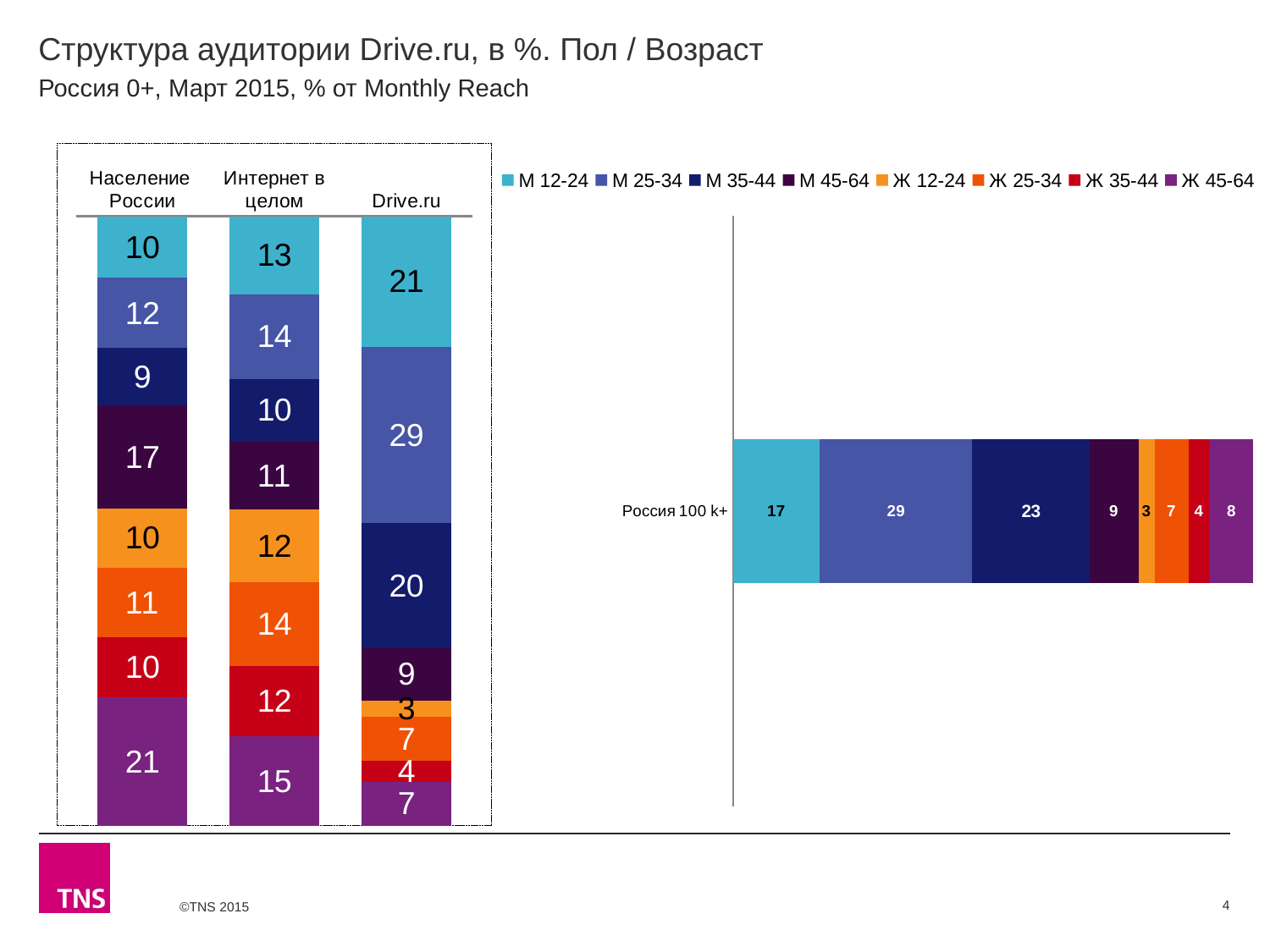
In the right chart, what is the value of the М 35-44 segment for Россия 100 k+? 23 How many series does the legend list? 8 In the left chart, which segment is the smallest in the Drive.ru bar? Ж 12-24 What is the total of the Drive.ru stacked bar in the left chart? 100 In the left chart, what is the value of the М 25-34 segment for Drive.ru? 29 In the left chart, which is larger: the Ж 45-64 value for Население России or for Drive.ru? Население России How many bars are in the left chart? 3 In the left chart, what is the value of the М 35-44 segment for Интернет в целом? 10 In the left chart, which segment is the largest in the Drive.ru bar? М 25-34 In the left chart, what is the difference between the М 12-24 value for Drive.ru and for Население России? 11 In the right chart, which segment is the smallest for Россия 100 k+? Ж 12-24 In the left chart, what is the value of the Ж 45-64 segment for Население России? 21